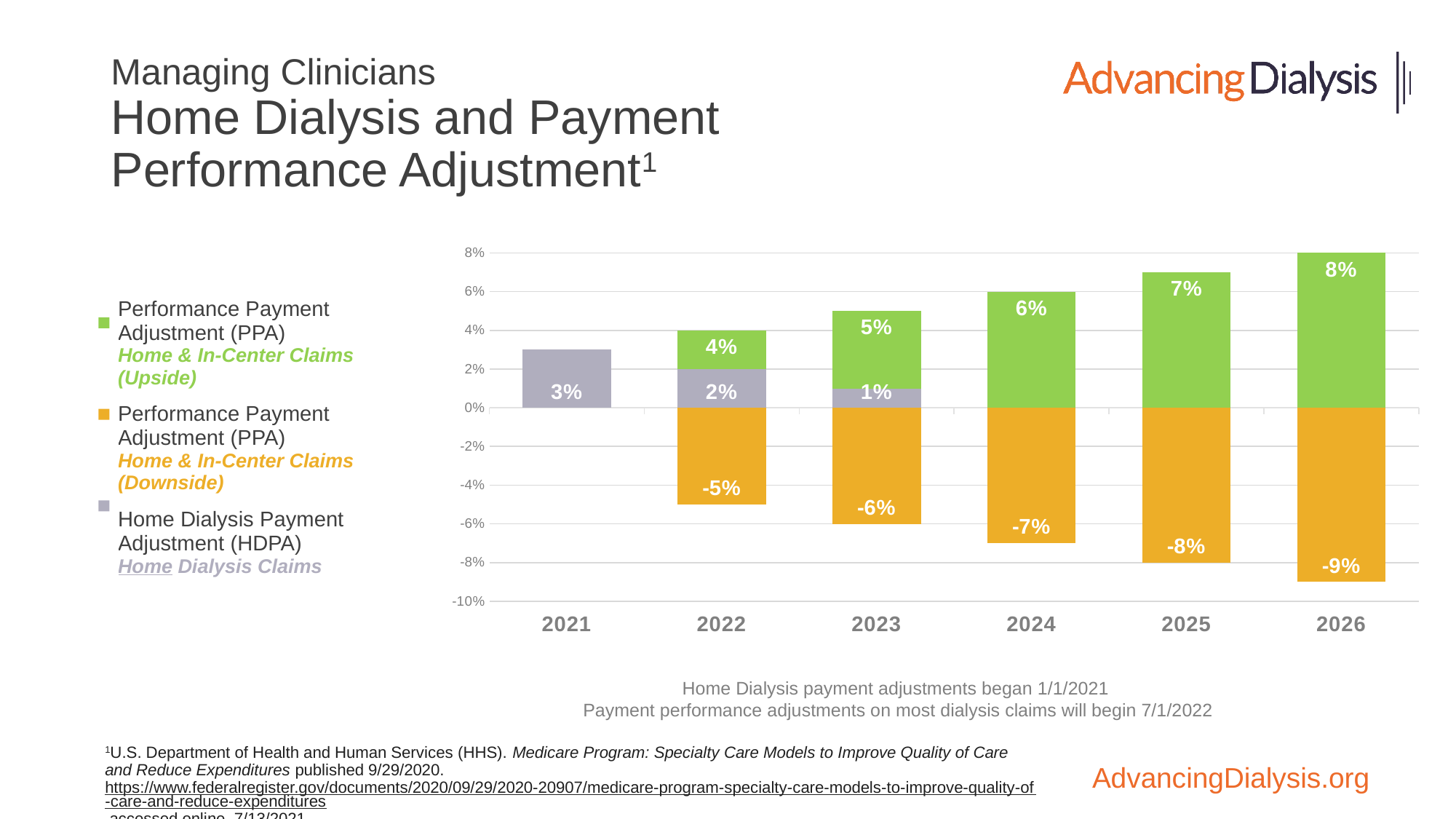
What is the difference between the PPA Upside values for 2025 and 2022? 3% In which year is the PPA Downside value lowest (most negative)? 2026 In which year is the PPA Upside value highest? 2026 What is the Performance Payment Adjustment (PPA) Upside value for 2024? 6% What is the HDPA value for 2023? 1% What is the Home Dialysis Payment Adjustment (HDPA) value for 2021? 3% What kind of chart is shown on the slide? bar chart How many series does the legend list? 3 How many years are shown on the x axis? 6 Do the PPA Upside values rise or fall from 2022 to 2026? rise Which is larger, the HDPA value for 2022 or the HDPA value for 2023? 2022 What is the Performance Payment Adjustment (PPA) Downside value for 2026? -9%